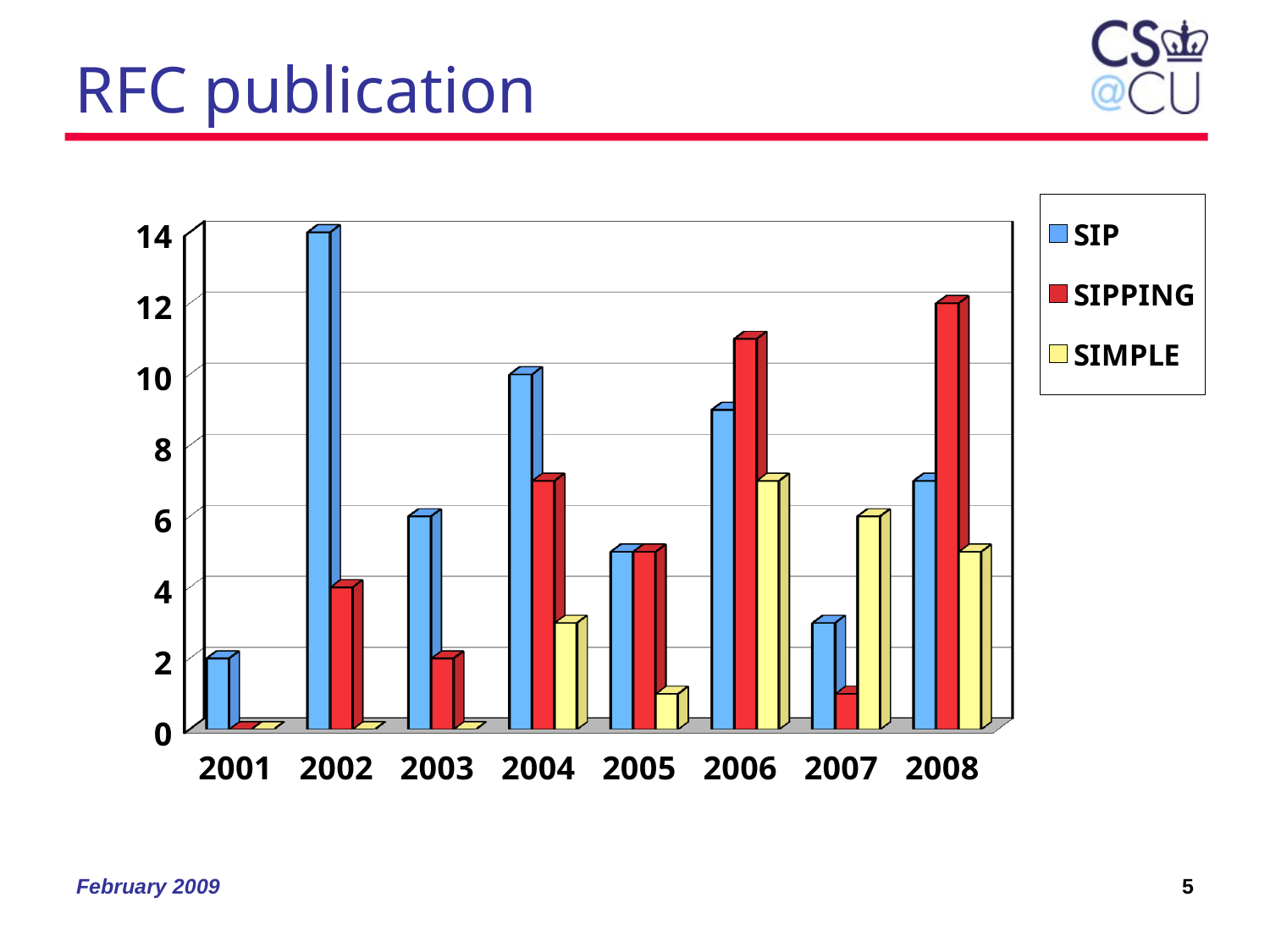
What is the SIPPING value for 2008? 12 Which colour represents SIMPLE in the legend? yellow In which year is the SIPPING value highest? 2008 How many years are shown on the x axis? 8 What is the SIP value for 2002? 14 In which year is the SIP value highest? 2002 Is the SIP value for 2007 greater or less than 4? less In 2007, which is larger, the SIP value or the SIMPLE value? SIMPLE Is the SIPPING value for 2006 greater or less than 10? greater How many series does the legend list? 3 What kind of chart is shown on the slide? bar chart What is the SIP value for 2004? 10